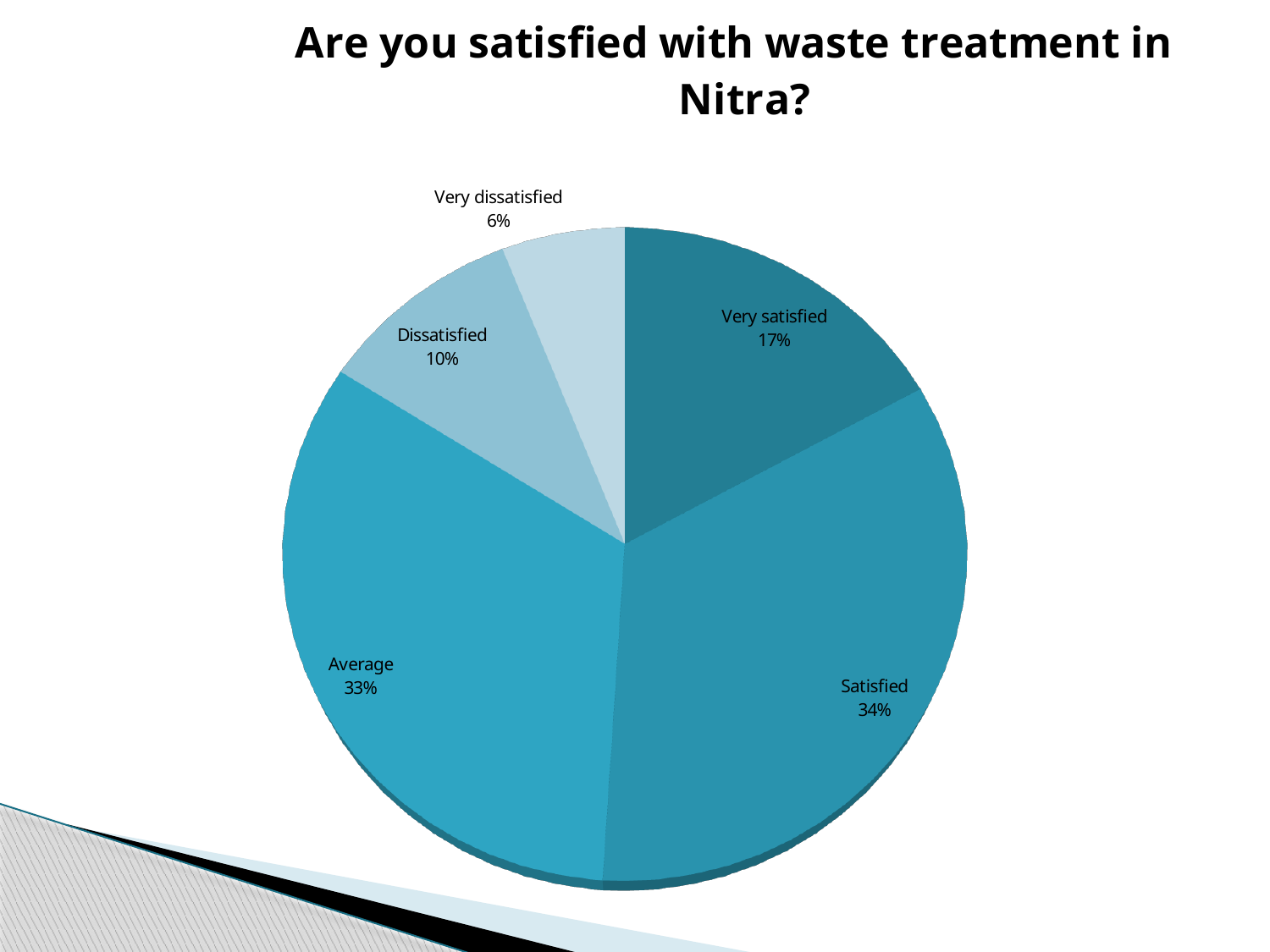
What kind of chart is shown on the slide? Pie chart Which is larger, the share for "Dissatisfied" or the share for "Very dissatisfied"? Dissatisfied What share of respondents answered "Average"? 33% Which response has the largest share of the pie? Satisfied Which response has the smallest share of the pie? Very dissatisfied What is the title of the chart? Are you satisfied with waste treatment in Nitra? What share of respondents answered "Very dissatisfied"? 6% What is the combined share of "Very satisfied" and "Satisfied"? 51% What share of respondents answered "Dissatisfied"? 10% How many slices does the pie chart have? 5 What is the difference in percentage points between "Satisfied" and "Very satisfied"? 17 What share of respondents answered "Very satisfied"? 17%